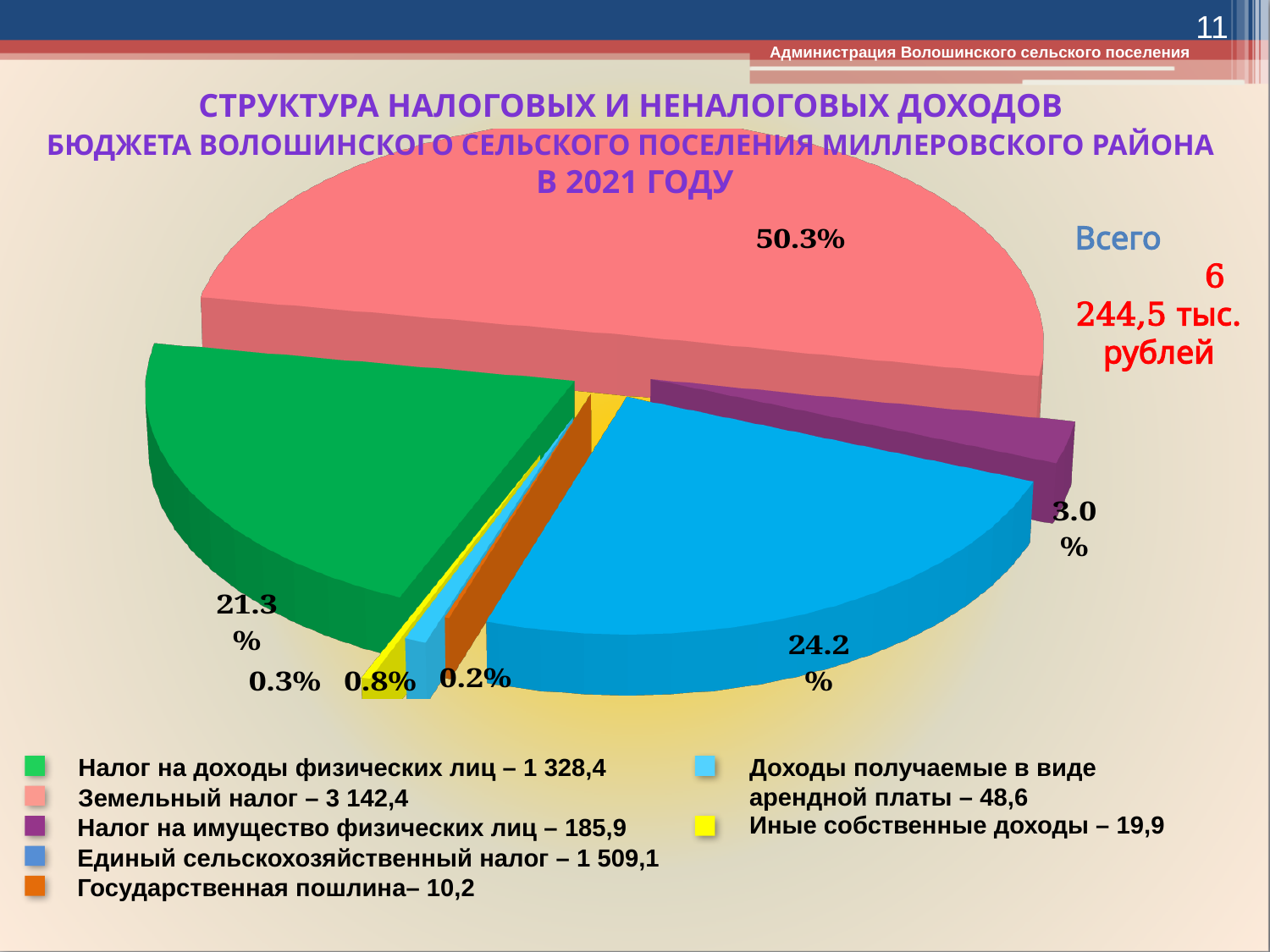
Which category has the smallest share of the pie? Государственная пошлина How many slices does the pie chart have? 7 What share of the pie does Земельный налог have? 50.3% What is the difference in percentage points between the shares of Земельный налог and Единый сельскохозяйственный налог? 26.1 What kind of chart is shown on the slide? pie chart What total amount (Всего) is shown next to the pie chart? 6 244,5 тыс. рублей What share of the pie does Налог на имущество физических лиц have? 3.0% What share of the pie does Единый сельскохозяйственный налог have? 24.2% What value is given in the legend for Доходы получаемые в виде арендной платы? 48,6 Which has a larger share: Налог на доходы физических лиц or Единый сельскохозяйственный налог? Единый сельскохозяйственный налог Which category has the largest share of the pie? Земельный налог